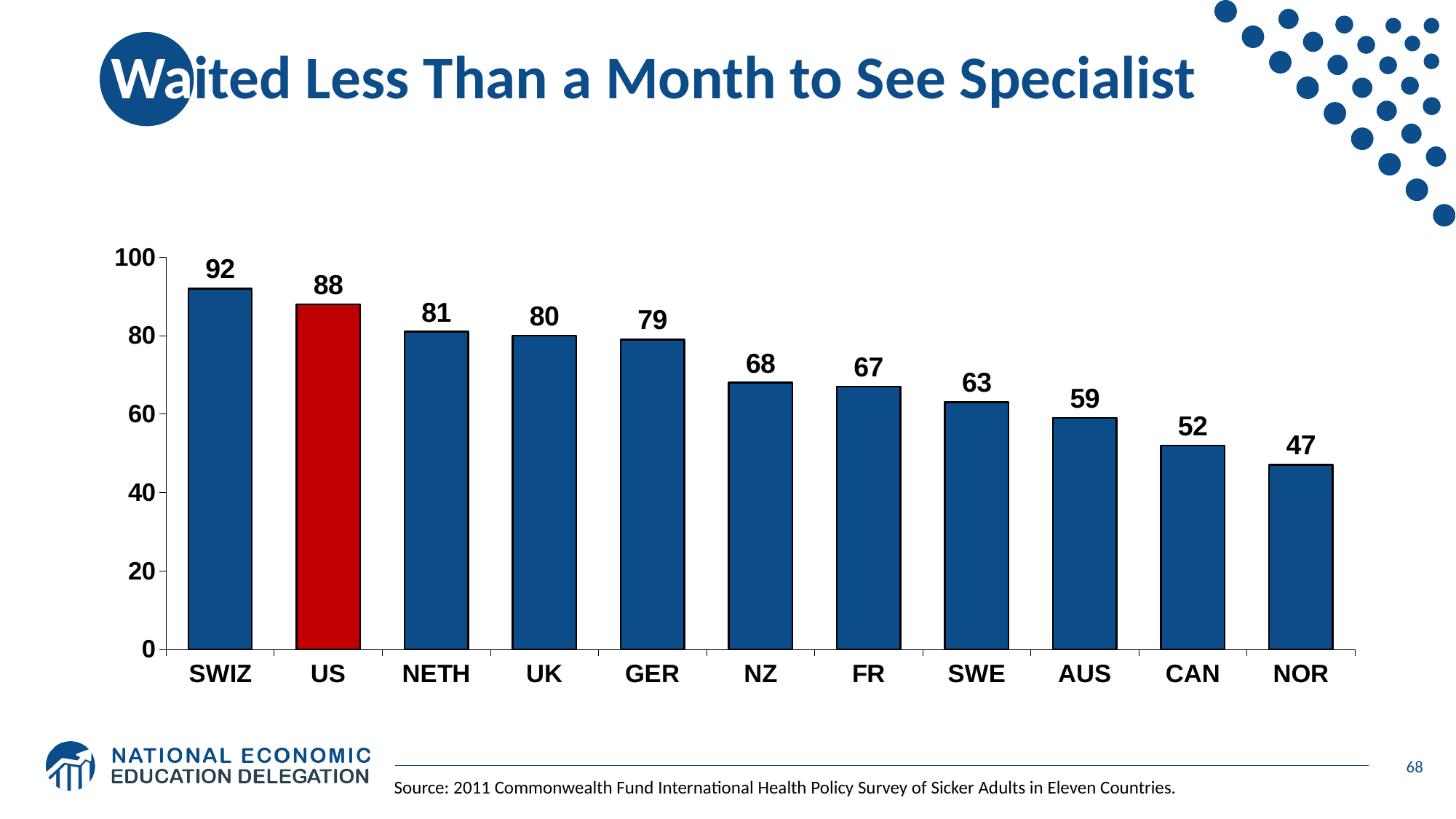
Is the value for FR greater or less than 60? greater What is the difference between the values for SWIZ and the US? 4 What is the value for GER? 79 What kind of chart is shown on the slide? bar chart How many countries are shown on the chart? 11 Which country has the highest value? SWIZ Which bar is coloured red rather than blue? US Which is larger, the value for SWE or the value for AUS? SWE What is the value for NOR? 47 What is the value for the US? 88 Which country has the lowest value? NOR What is the difference between the values for NZ and CAN? 16